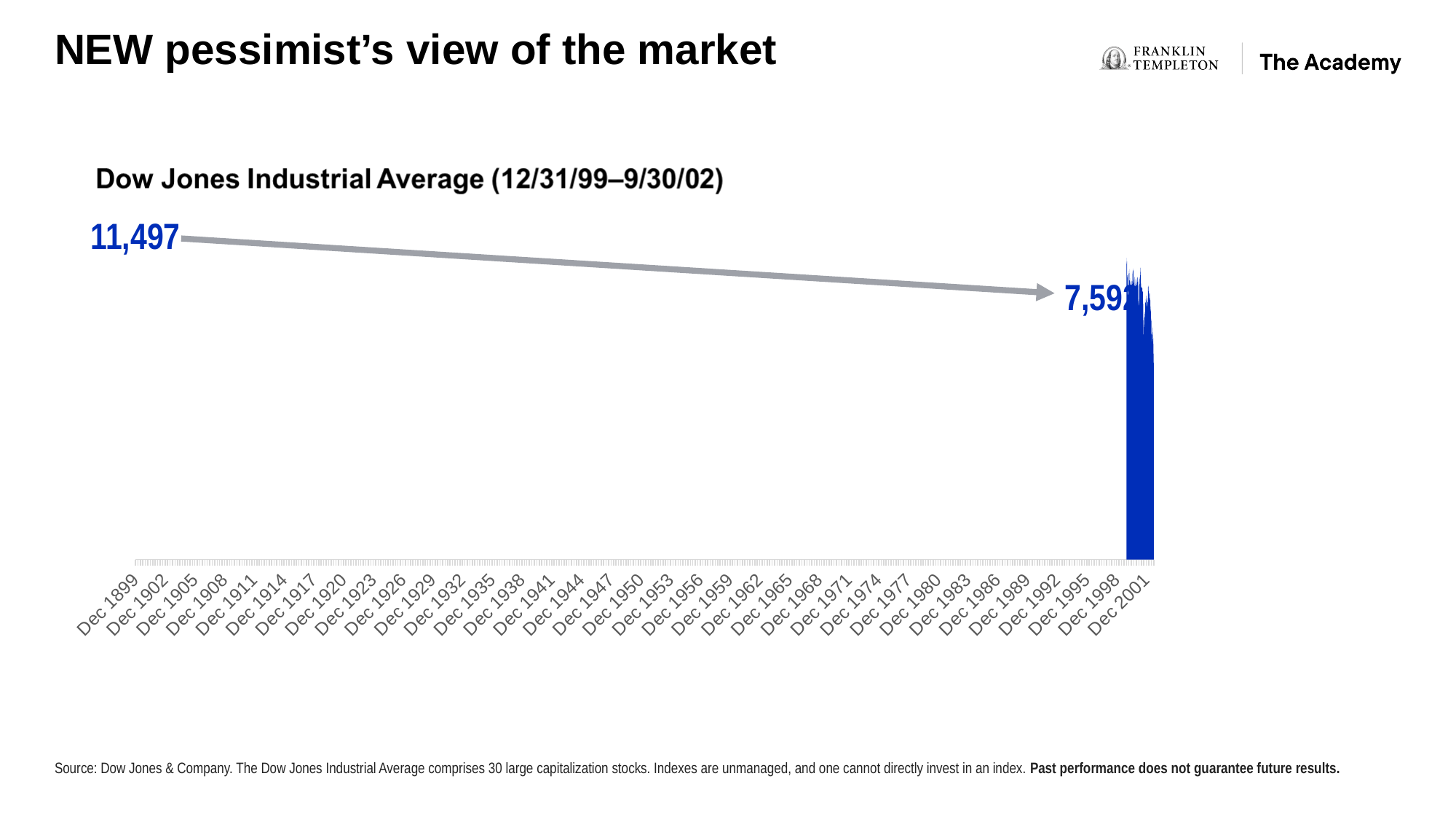
Is the ending value shown at the arrow tip greater or less than 8,000? less How many years apart are consecutive date labels on the x axis? 3 years What is the last date label on the x axis? Dec 2001 What is the starting value labelled at the left end of the arrow on the chart? 11,497 What colour is the plotted data area on the chart? blue Which is larger, the value at the start of the arrow or the value at the end of the arrow? the value at the start (11,497) Does the Dow Jones Industrial Average rise or fall from the start to the end of the period shown by the arrow? fall Is the starting value of 11,497 greater or less than 10,000? greater What is the title of the chart? Dow Jones Industrial Average (12/31/99–9/30/02)